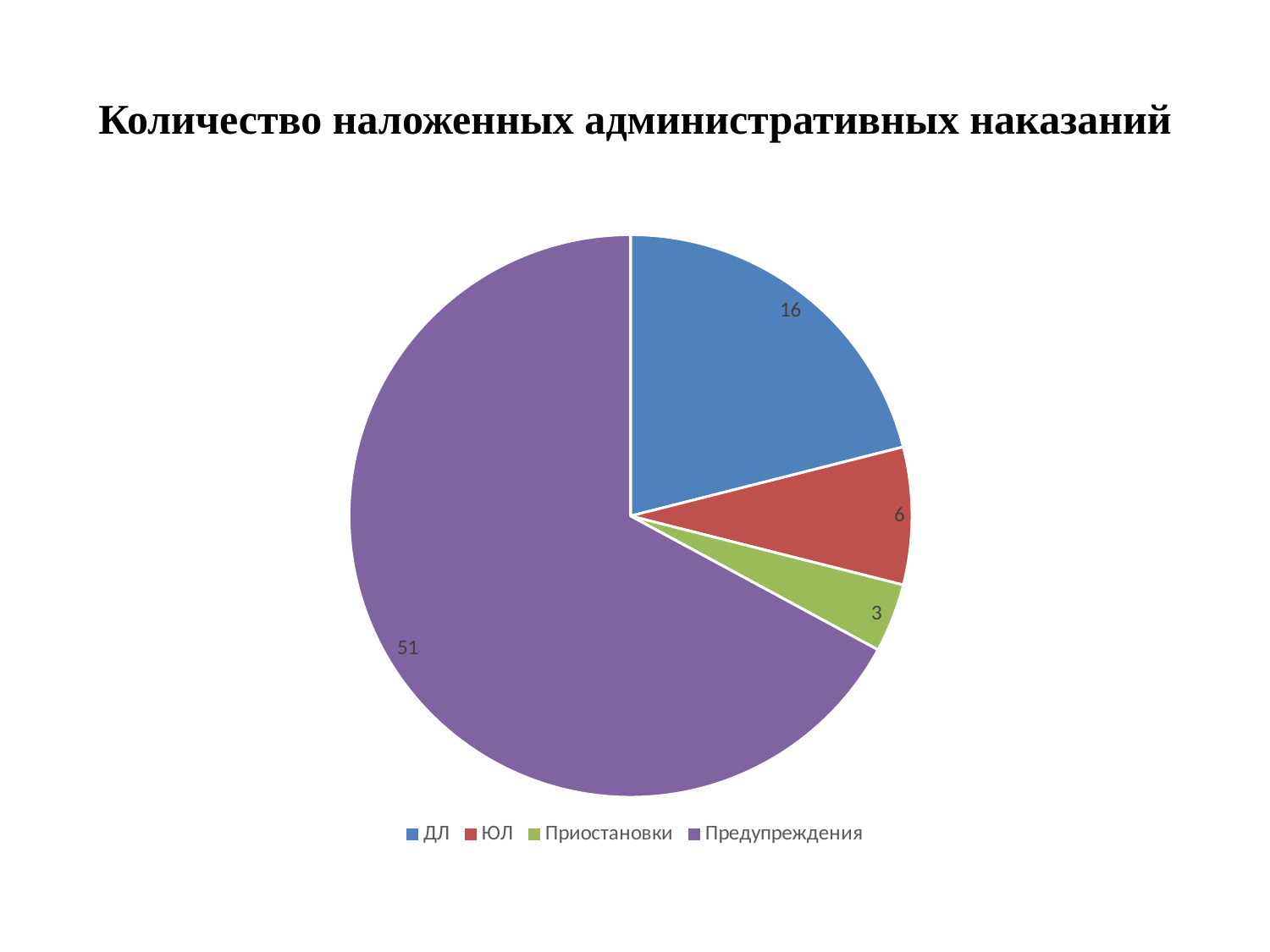
What is the value for ДЛ? 16 How many categories does the pie chart have? 4 What is the difference between the values for Предупреждения and ДЛ? 35 What is the value for ЮЛ? 6 Which category has the smallest slice of the pie? Приостановки What kind of chart is shown on the slide? pie chart What is the value for Предупреждения? 51 What is the title of the chart? Количество наложенных административных наказаний Which category has the largest slice of the pie? Предупреждения Which is larger, the value for ДЛ or the value for ЮЛ? ДЛ What is the value for Приостановки? 3 What is the total of all the slices in the pie chart? 76